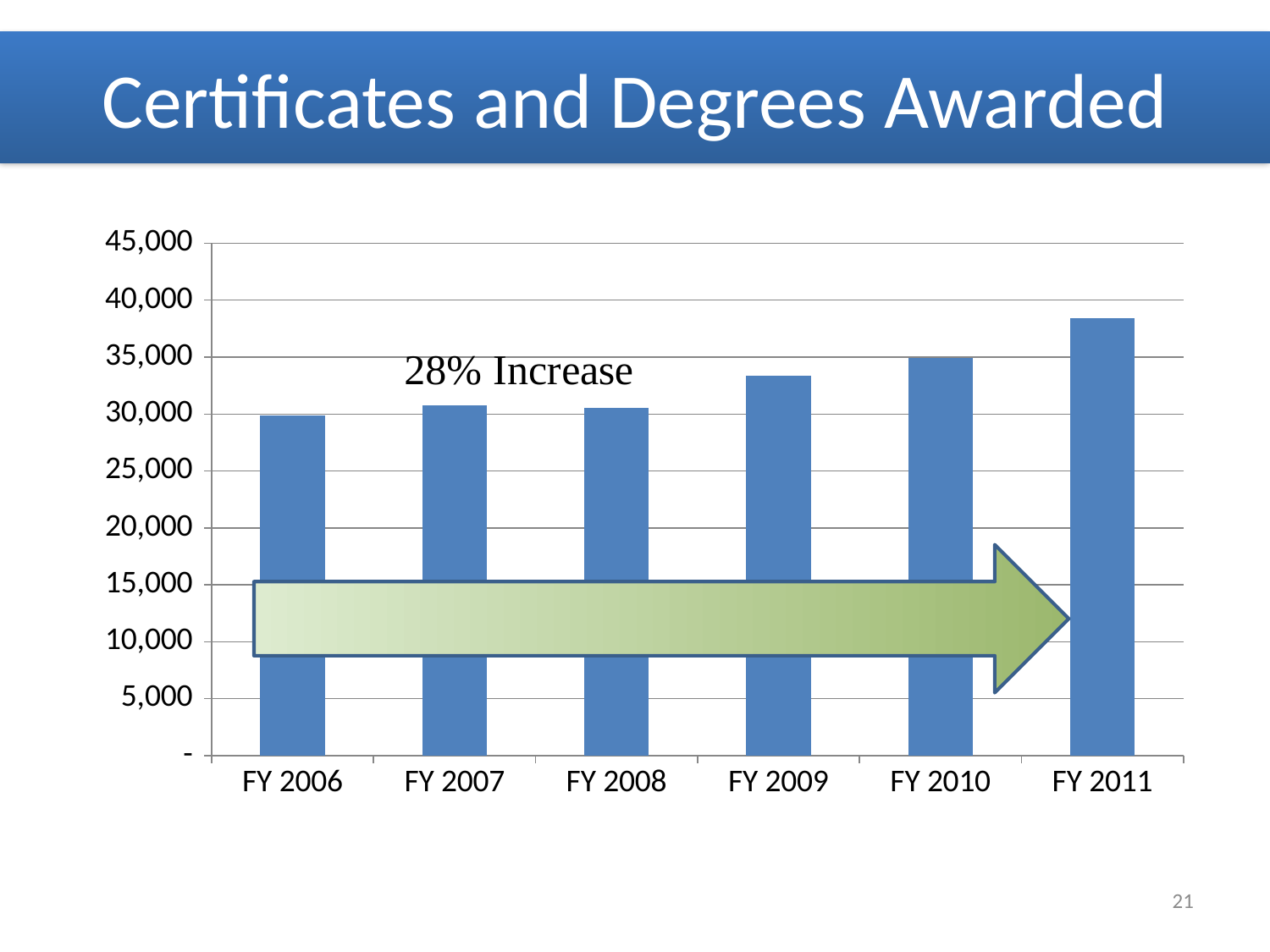
How many fiscal years are shown on the x axis of the chart? 6 Which fiscal year has the highest number of certificates and degrees awarded? FY 2011 Which is larger, the value for FY 2010 or the value for FY 2009? FY 2010 Do the values generally rise or fall from FY 2006 to FY 2011? Rise Is the value for FY 2009 greater or less than 30,000? greater What kind of chart is shown on the slide? Bar chart Which fiscal year has the lowest number of certificates and degrees awarded? FY 2006 What percentage increase is annotated on the chart? 28% Increase Is the value for FY 2011 greater or less than 35,000? greater Is the value for FY 2011 greater or less than 40,000? less Which is larger, the value for FY 2011 or the value for FY 2006? FY 2011